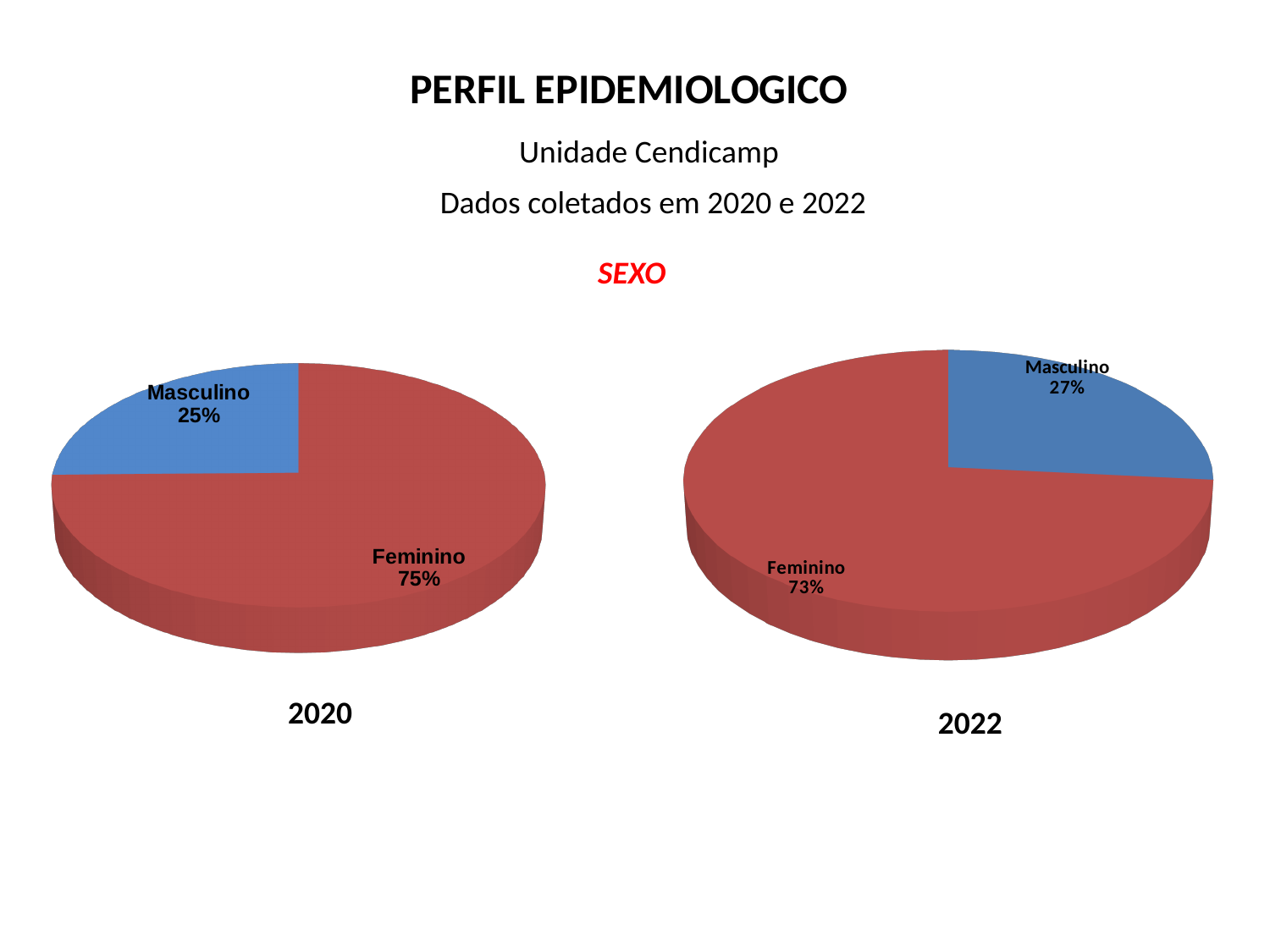
What colour is the Masculino slice in the 2020 pie chart? Blue Which is larger: the Feminino share in the 2020 chart or the Feminino share in the 2022 chart? 2020 In the 2022 pie chart, what is the share for Masculino? 27% In the 2020 pie chart, which category has the largest slice? Feminino What type of chart is used for the 2020 data? Pie chart In the 2022 pie chart, what is the share for Feminino? 73% In the 2020 pie chart, what is the share for Feminino? 75% What is the difference between the Masculino share in 2022 and the Masculino share in 2020? 2% In the 2022 pie chart, which category has the smallest slice? Masculino How many slices does the 2022 pie chart have? 2 What is the difference between the Feminino and Masculino shares in the 2020 pie chart? 50% In the 2020 pie chart, what is the share for Masculino? 25%